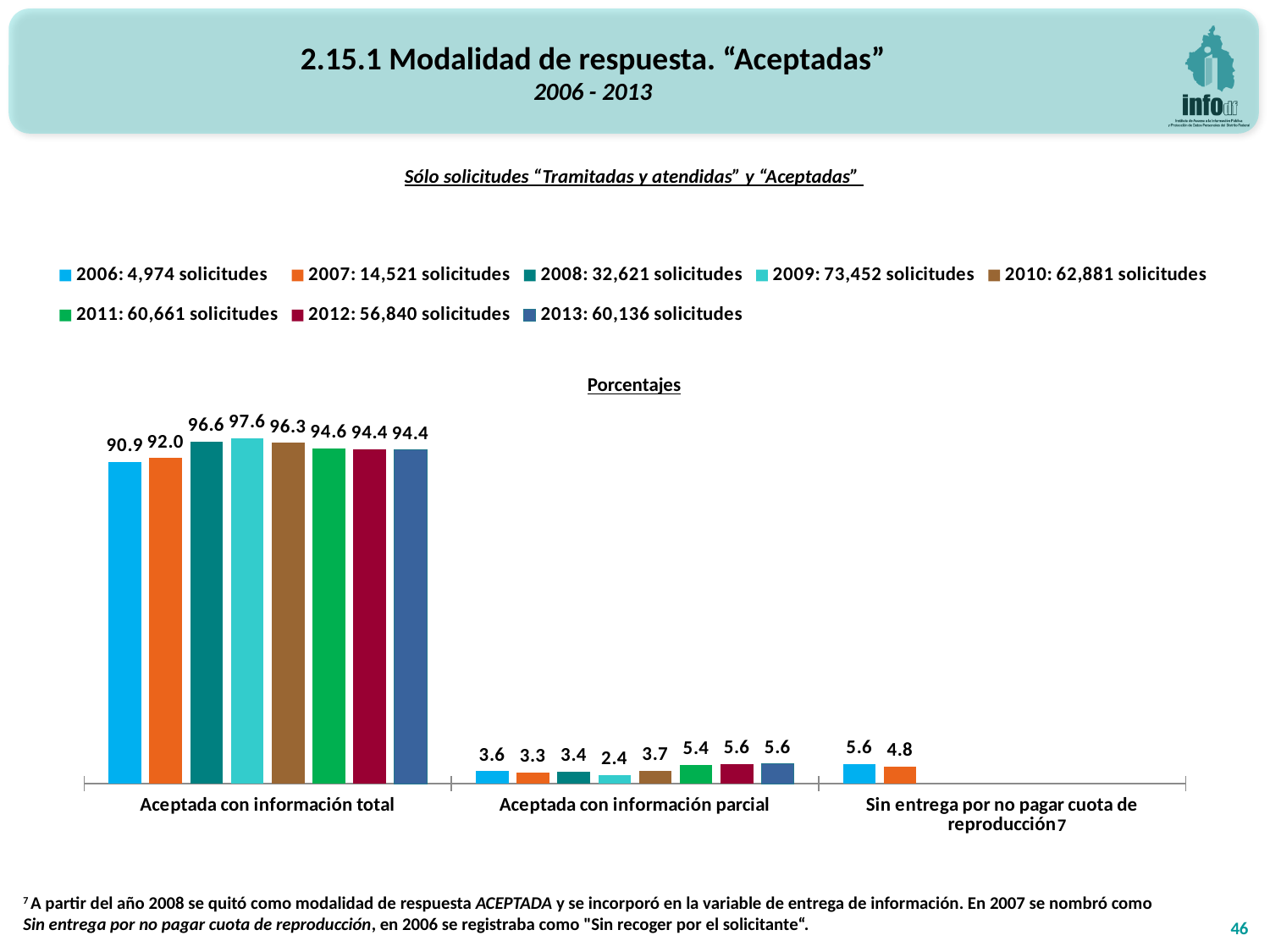
What is the difference between the 2009 and 2006 values in the "Aceptada con información total" category? 6.7 Which year has the lowest value in the "Aceptada con información parcial" category? 2009 What is the value for 2009 in the "Aceptada con información total" category? 97.6 What is the value for 2007 in the "Sin entrega por no pagar cuota de reproducción" category? 4.8 How many bars are plotted in the "Sin entrega por no pagar cuota de reproducción" category? 2 How many categories are shown on the x axis? 3 What is the value for 2006 in the "Aceptada con información parcial" category? 3.6 How many series does the legend list? 8 What kind of chart is shown on the slide? Bar chart According to the legend, how many solicitudes were there in 2009? 73,452 Which is larger in the "Aceptada con información parcial" category: the value for 2010 or the value for 2011? 2011 Which year has the highest value in the "Aceptada con información total" category? 2009